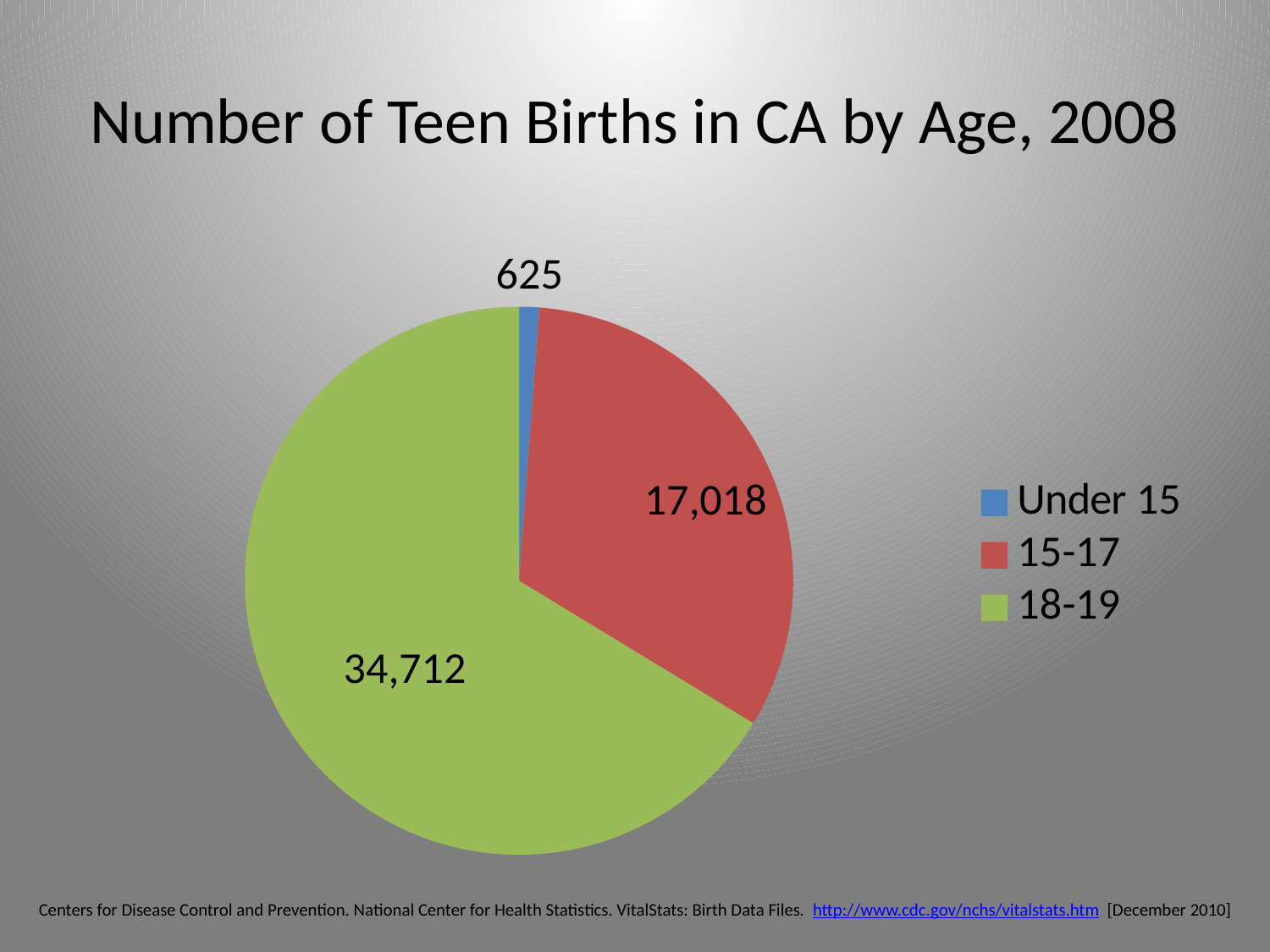
What is the difference in teen births between the 15-17 and Under 15 age groups? 16,393 What is the title of the chart? Number of Teen Births in CA by Age, 2008 Which age group has more teen births, 15-17 or Under 15? 15-17 What share of the total teen births does the 18-19 age group represent? 66.3% How many teen births are shown for the 15-17 age group? 17,018 How many teen births are shown for the Under 15 age group? 625 Which age group has the smallest number of teen births? Under 15 Which age group has the largest number of teen births? 18-19 What is the difference in teen births between the 18-19 and 15-17 age groups? 17,694 How many age groups are shown in the pie chart? 3 How many teen births are shown for the 18-19 age group? 34,712 What type of chart is shown on the slide? Pie chart